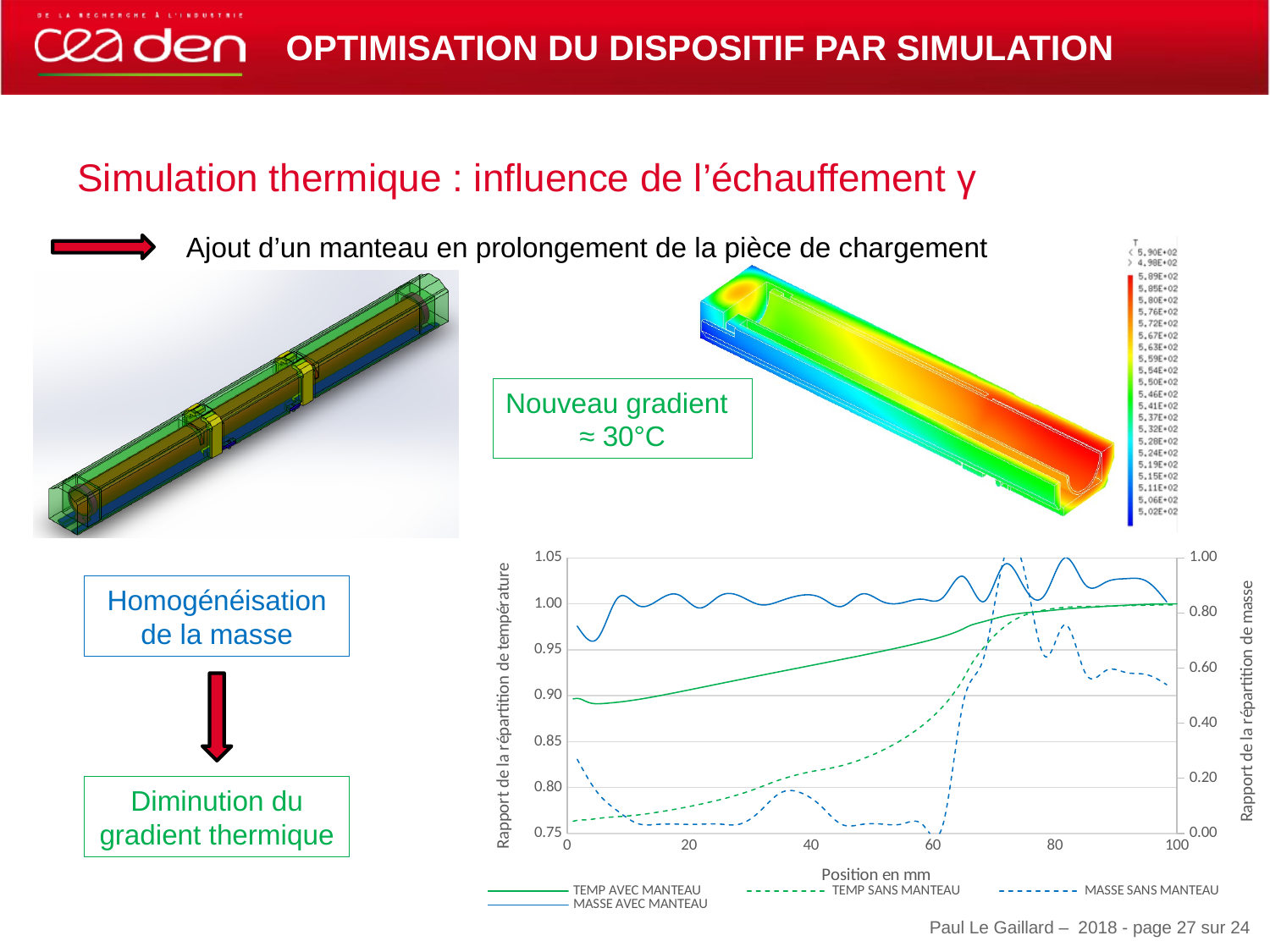
In the line chart, is the value of TEMP SANS MANTEAU at position 40 mm greater or less than 0.85 on the left axis? less How many series does the legend of the line chart list? 4 What kind of chart is shown at the bottom right of the slide? line chart What is the title of the x axis of the line chart? Position en mm What is the title of the left y axis of the line chart? Rapport de la répartition de température In the line chart, does the TEMP SANS MANTEAU series rise or fall as position increases from 0 to 100 mm? rise In the line chart, at position 0 mm, which is larger: TEMP AVEC MANTEAU or TEMP SANS MANTEAU? TEMP AVEC MANTEAU In the line chart, at position 20 mm, which is larger: TEMP AVEC MANTEAU or TEMP SANS MANTEAU? TEMP AVEC MANTEAU In the line chart, is the value of TEMP AVEC MANTEAU at position 0 mm greater or less than 0.95 on the left axis? less In the line chart, is the value of TEMP SANS MANTEAU at position 20 mm greater or less than 0.80 on the left axis? less In the line chart, does the TEMP AVEC MANTEAU series rise or fall as position increases from 0 to 100 mm? rise What is the highest tick value shown on the x axis of the line chart? 100